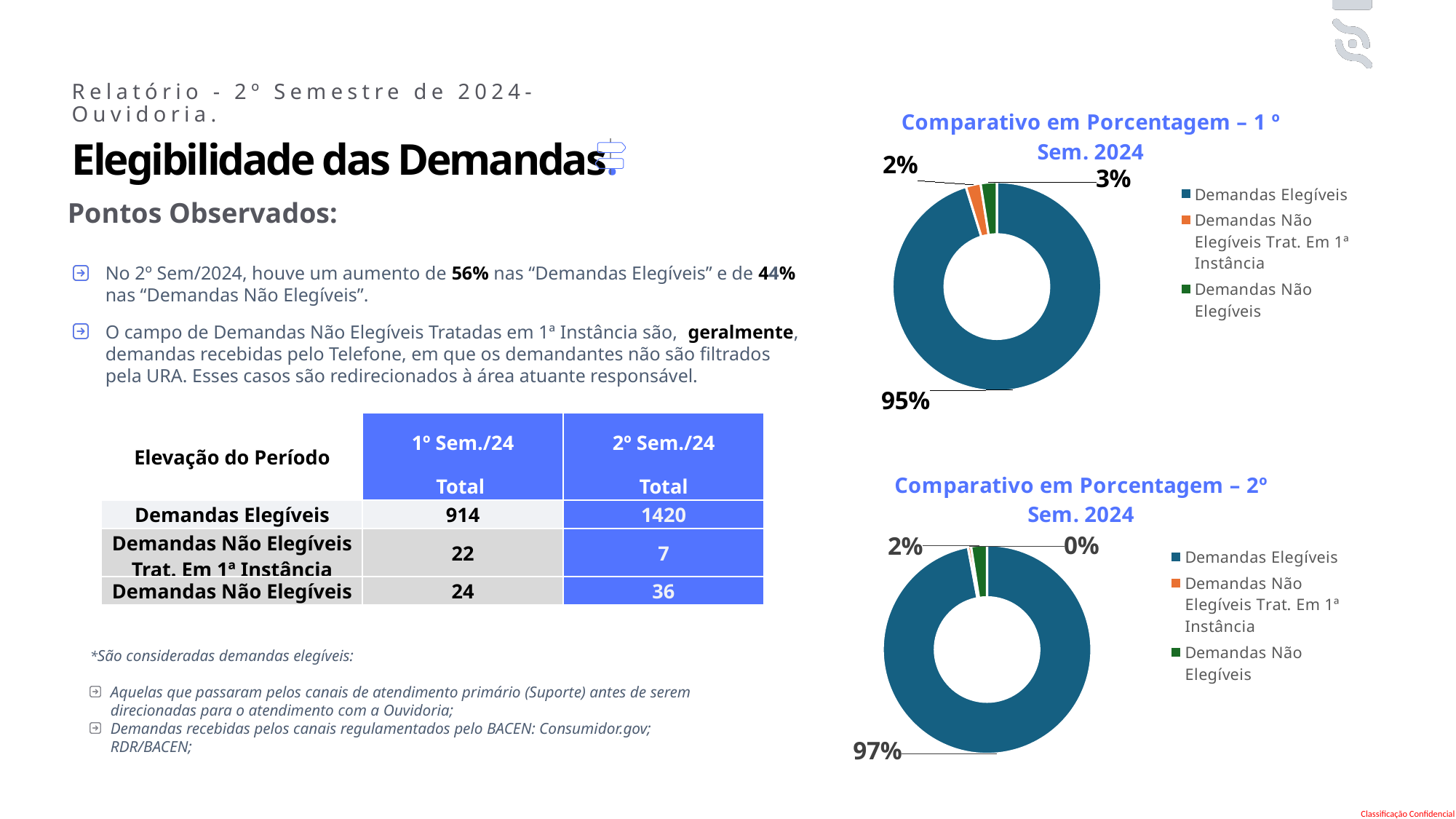
In the chart titled "Comparativo em Porcentagem – 2º Sem. 2024", what percentage is shown for Demandas Não Elegíveis? 2% In the chart titled "Comparativo em Porcentagem – 1º Sem. 2024", which category has the largest share? Demandas Elegíveis What kind of chart is "Comparativo em Porcentagem – 2º Sem. 2024"? Pie (donut) chart Is the share of Demandas Elegíveis larger in the 1º Sem. 2024 chart or in the 2º Sem. 2024 chart? 2º Sem. 2024 How many charts are shown on the slide? 2 In the chart titled "Comparativo em Porcentagem – 1º Sem. 2024", what percentage is shown for Demandas Elegíveis? 95% In the chart titled "Comparativo em Porcentagem – 2º Sem. 2024", what percentage is shown for Demandas Não Elegíveis Trat. Em 1ª Instância? 0% In the chart titled "Comparativo em Porcentagem – 1º Sem. 2024", what colour represents Demandas Elegíveis? Dark blue What is the difference between the Demandas Elegíveis share in the 2º Sem. 2024 chart and in the 1º Sem. 2024 chart? 2% How many categories does the legend of the chart titled "Comparativo em Porcentagem – 1º Sem. 2024" list? 3 In the chart titled "Comparativo em Porcentagem – 2º Sem. 2024", what percentage is shown for Demandas Elegíveis? 97% In the chart titled "Comparativo em Porcentagem – 2º Sem. 2024", which category has the smallest share? Demandas Não Elegíveis Trat. Em 1ª Instância